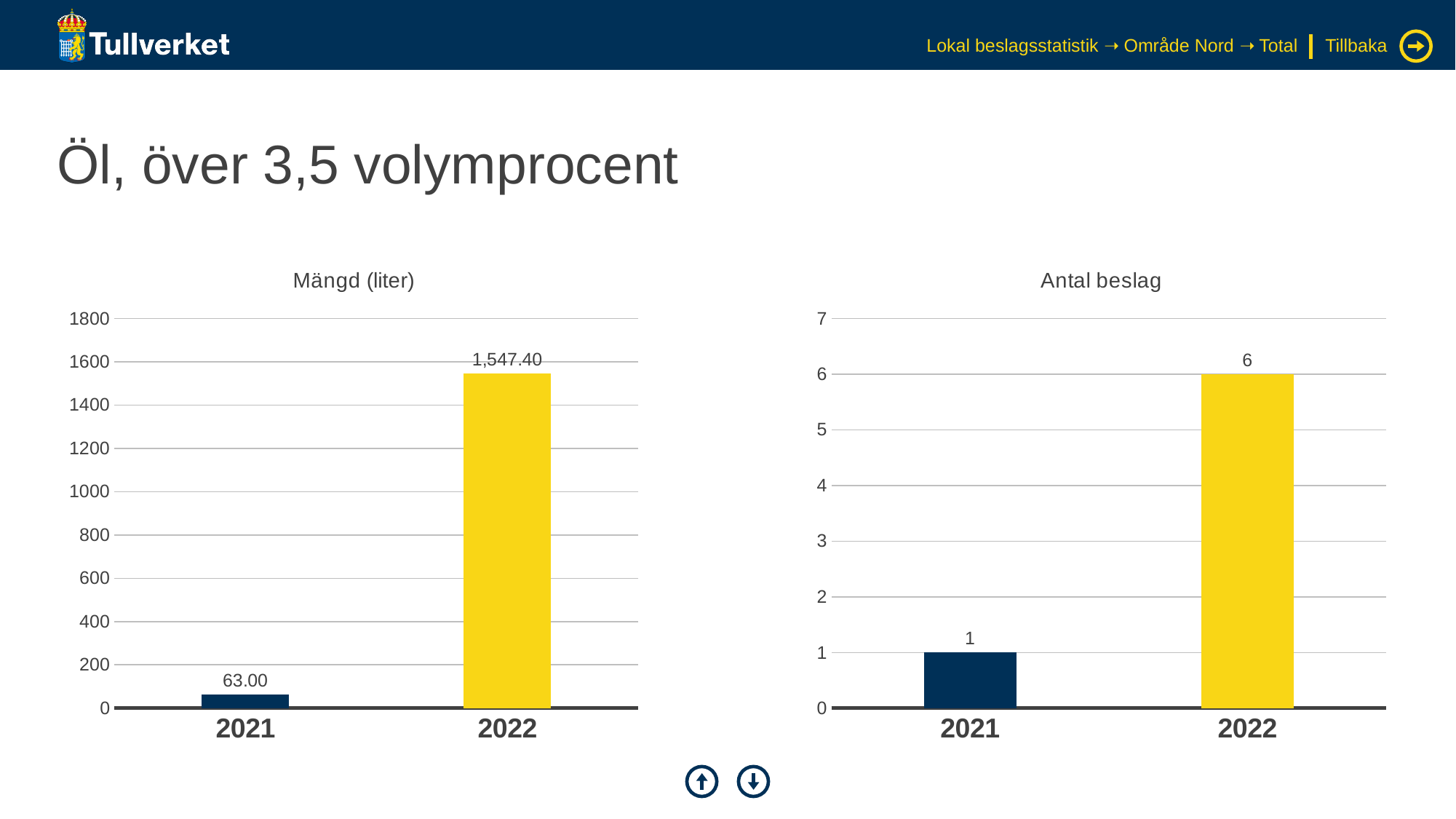
In the 'Mängd (liter)' chart, is the value for 2022 greater or less than 1400? greater In the 'Mängd (liter)' chart, which year has the highest value? 2022 In the 'Antal beslag' chart, what is the value for 2021? 1 In the 'Antal beslag' chart, what is the value for 2022? 6 In the 'Antal beslag' chart, which year has the lowest value? 2021 In the 'Mängd (liter)' chart, what is the difference between the values for 2022 and 2021? 1,484.40 In the 'Mängd (liter)' chart, what is the value for 2021? 63.00 What kind of chart is the 'Mängd (liter)' chart? bar chart How many years are shown in the 'Antal beslag' chart? 2 In the 'Antal beslag' chart, what is the difference between the values for 2022 and 2021? 5 In the 'Antal beslag' chart, do the values rise or fall from 2021 to 2022? rise In the 'Mängd (liter)' chart, what is the value for 2022? 1,547.40